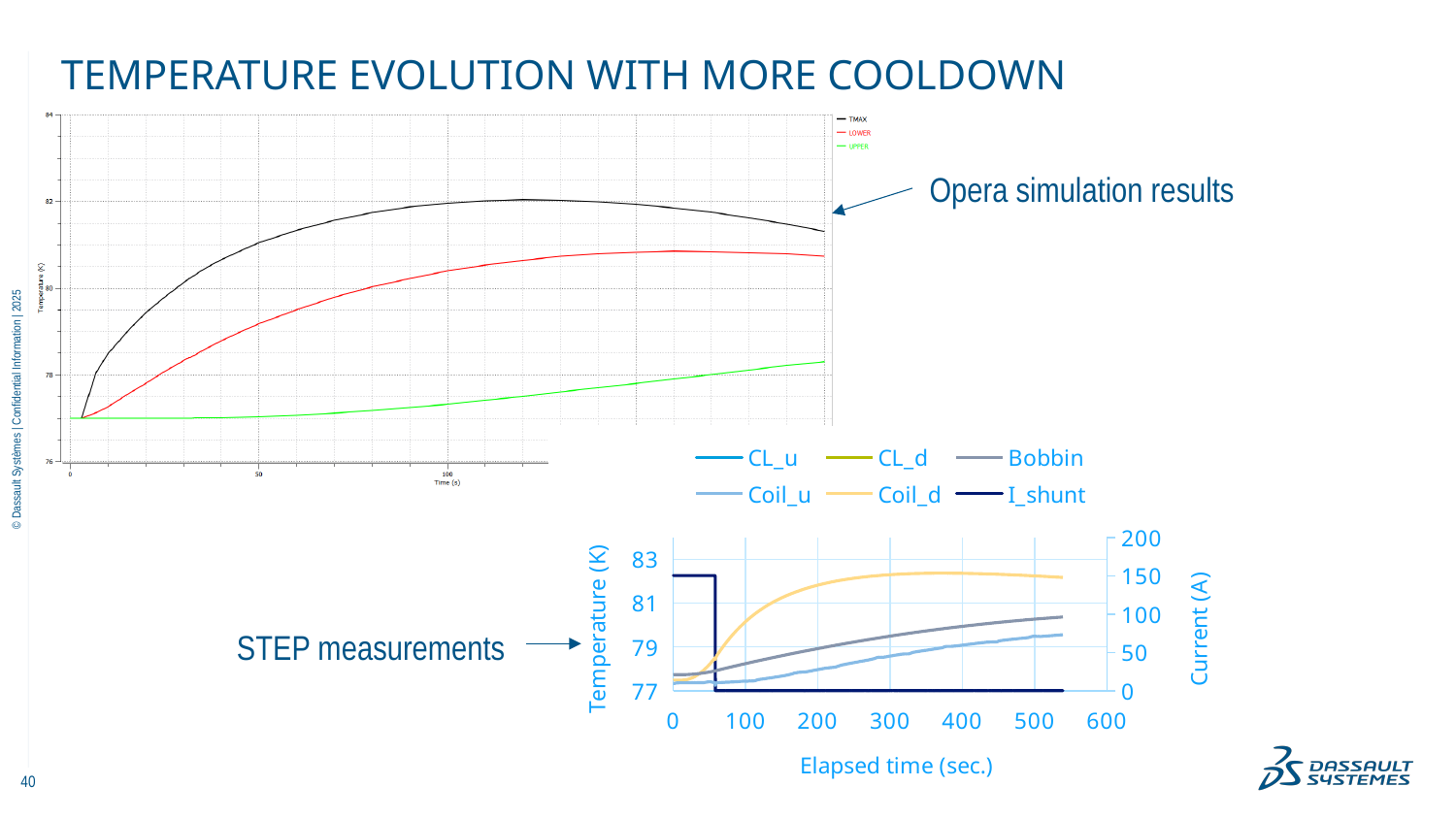
In the STEP measurements chart, does the Bobbin temperature rise or fall as elapsed time increases? rise What kind of chart is the Opera simulation results chart at the top left of the slide? line chart In the Opera simulation results chart, which series has the highest temperature values? TMAX What is the x-axis title of the STEP measurements chart? Elapsed time (sec.) In the STEP measurements chart, is the Coil_d temperature at 300 s greater or less than 81? greater What kind of chart is the STEP measurements chart at the bottom right of the slide? line chart How many series does the legend of the STEP measurements chart list? 6 In the Opera simulation results chart, which series has the lowest temperature values? UPPER In the STEP measurements chart, which temperature series reaches the highest values? Coil_d In the Opera simulation results chart, is the TMAX value at time 50 s greater or less than 80? greater In the Opera simulation results chart, is the LOWER value at time 50 s greater or less than 80? less How many series does the legend of the Opera simulation results chart list? 3